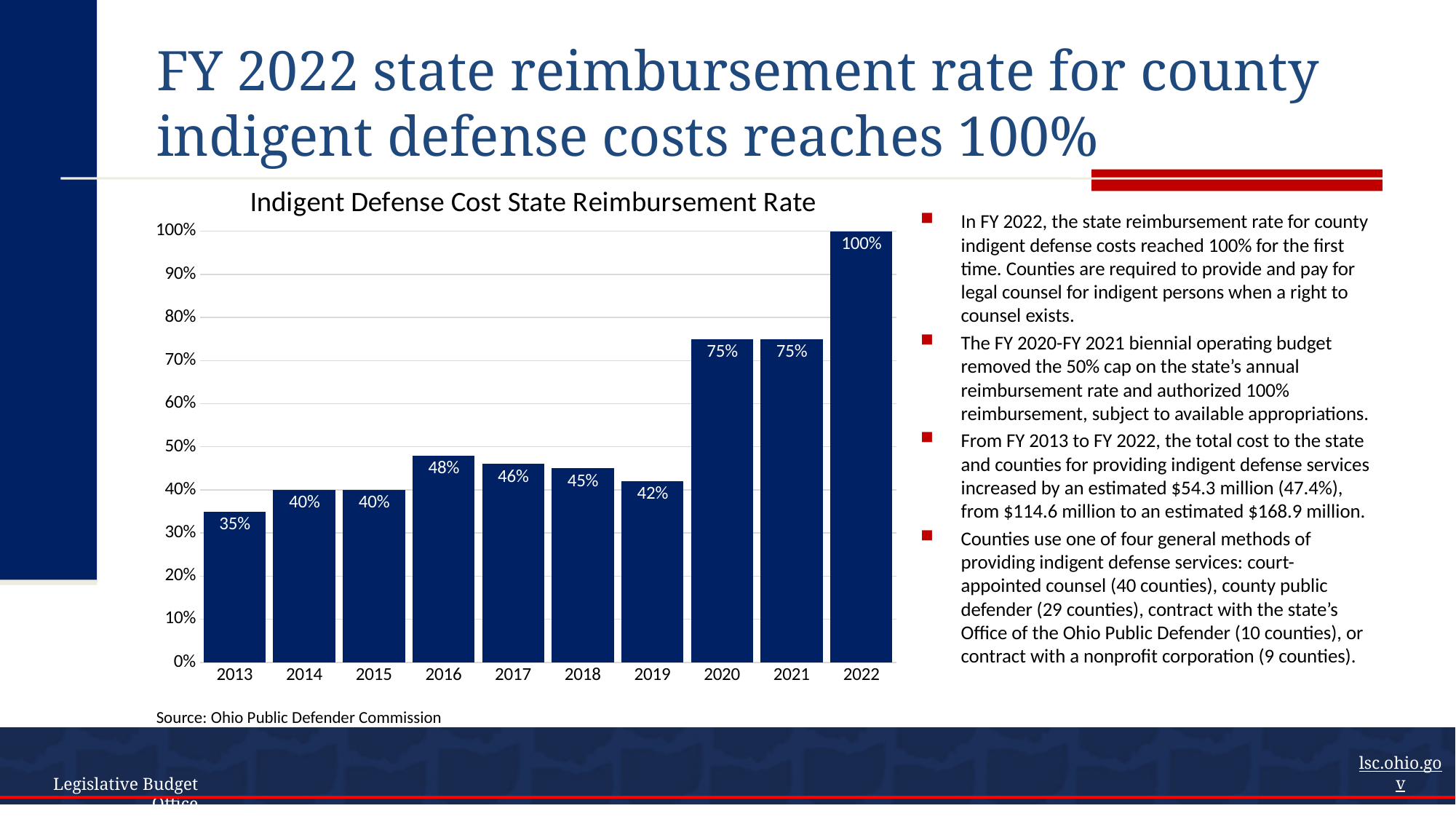
What is the difference between the reimbursement rate in 2016 and in 2013? 13% Which year has the lowest reimbursement rate in the chart? 2013 What is the difference between the reimbursement rate in 2022 and in 2021? 25% What is the title of the chart on the slide? Indigent Defense Cost State Reimbursement Rate How many years are shown on the x axis of the chart? 10 Is the reimbursement rate for 2020 greater or less than 70%? greater What is the state reimbursement rate shown for 2019? 42% Which year has a higher reimbursement rate, 2017 or 2019? 2017 Which year has the highest reimbursement rate in the chart? 2022 What is the state reimbursement rate shown for 2016? 48% What is the state reimbursement rate shown for 2013? 35% What type of chart is used to show the Indigent Defense Cost State Reimbursement Rate? Bar chart